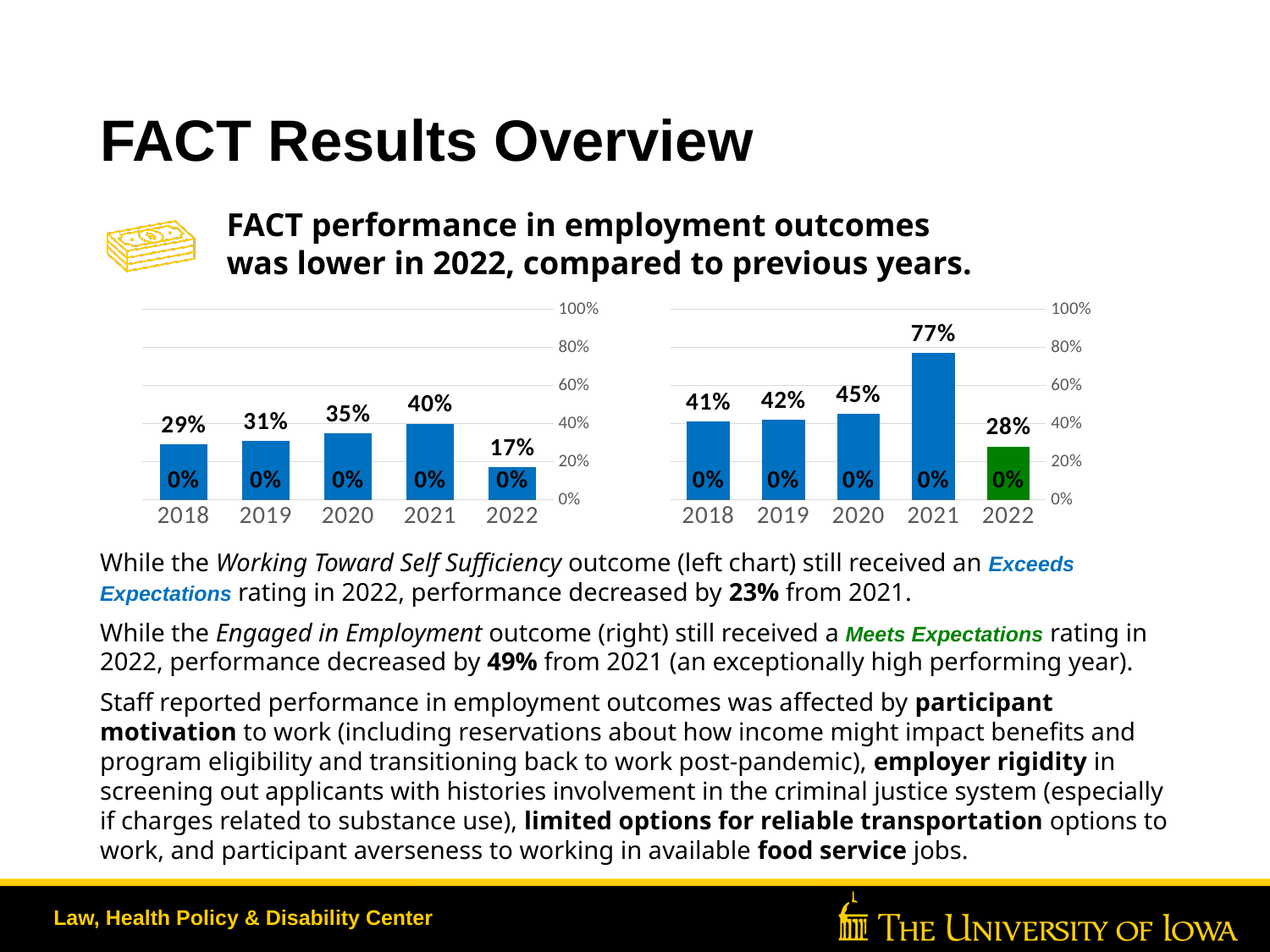
In the right chart, what is the difference between the 2021 value and the 2022 value? 49% In the right chart, what is the value for 2022? 28% In the right chart, which year has the highest value? 2021 In the left chart, do the values rise or fall from 2018 to 2021? rise In the right chart, is the value for 2021 greater or less than 60%? greater In the left chart, which year has the lowest value? 2022 How many years are shown on the x axis of the left chart? 5 In the left chart, what is the value for 2021? 40% What type of chart is the right chart? bar chart In the right chart, which is larger, the value for 2019 or the value for 2020? 2020 In the left chart, what is the value for 2018? 29% In the left chart, what is the difference between the 2021 value and the 2022 value? 23%